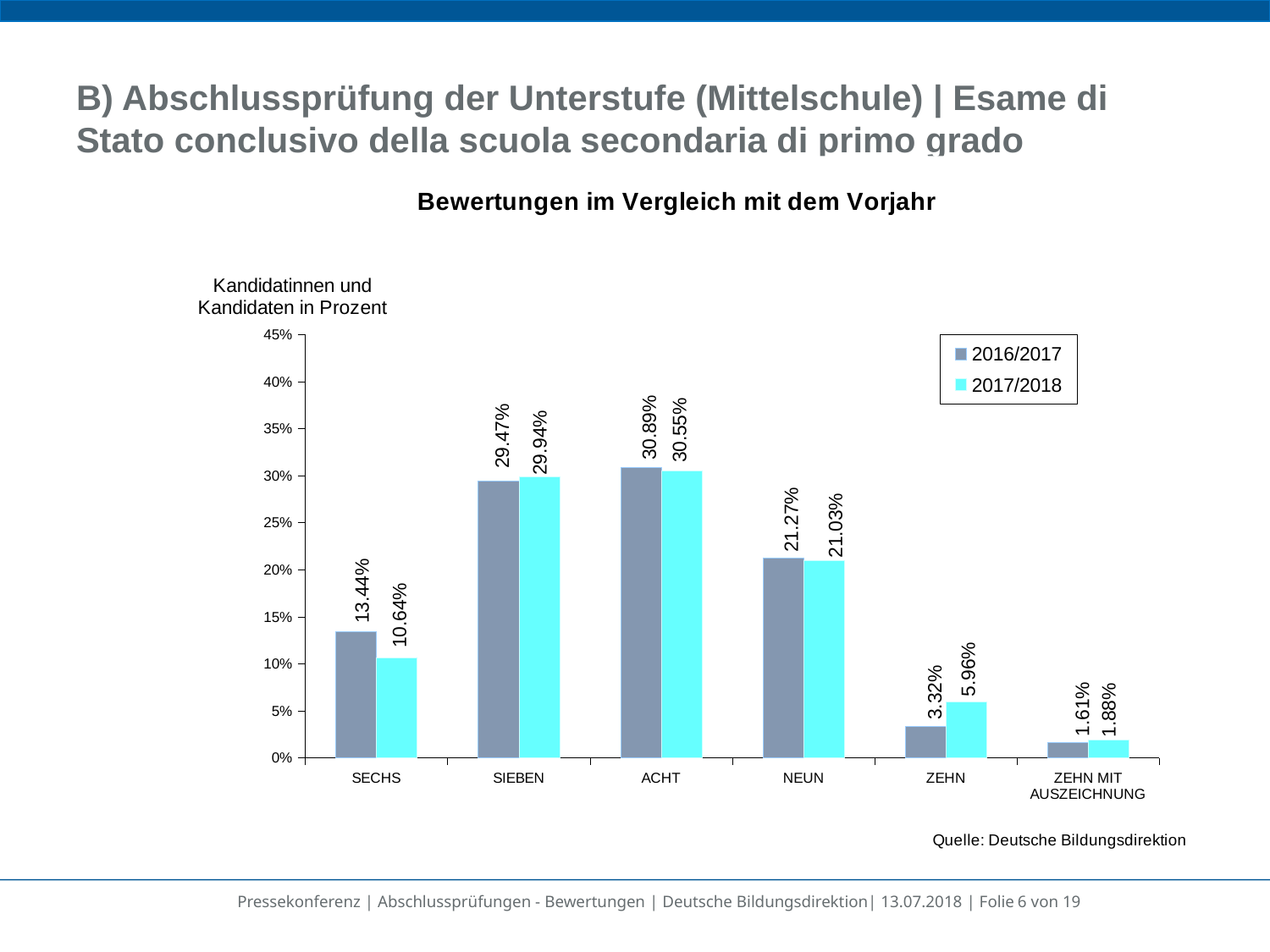
How many series does the legend list? 2 How many grade categories are shown on the x axis? 6 Which category has the lowest value in the 2016/2017 series? ZEHN MIT AUSZEICHNUNG What is the difference between the 2017/2018 and 2016/2017 values for ZEHN? 2.64% What is the value for ZEHN in the 2017/2018 series? 5.96% Which category has the highest value in the 2017/2018 series? ACHT What kind of chart is shown on the slide? Bar chart What is the value for SECHS in the 2016/2017 series? 13.44% What is the value for ZEHN MIT AUSZEICHNUNG in the 2016/2017 series? 1.61% What is the difference between the 2016/2017 and 2017/2018 values for SECHS? 2.80% For NEUN, which series has the larger value, 2016/2017 or 2017/2018? 2016/2017 What is the title of the chart? Bewertungen im Vergleich mit dem Vorjahr